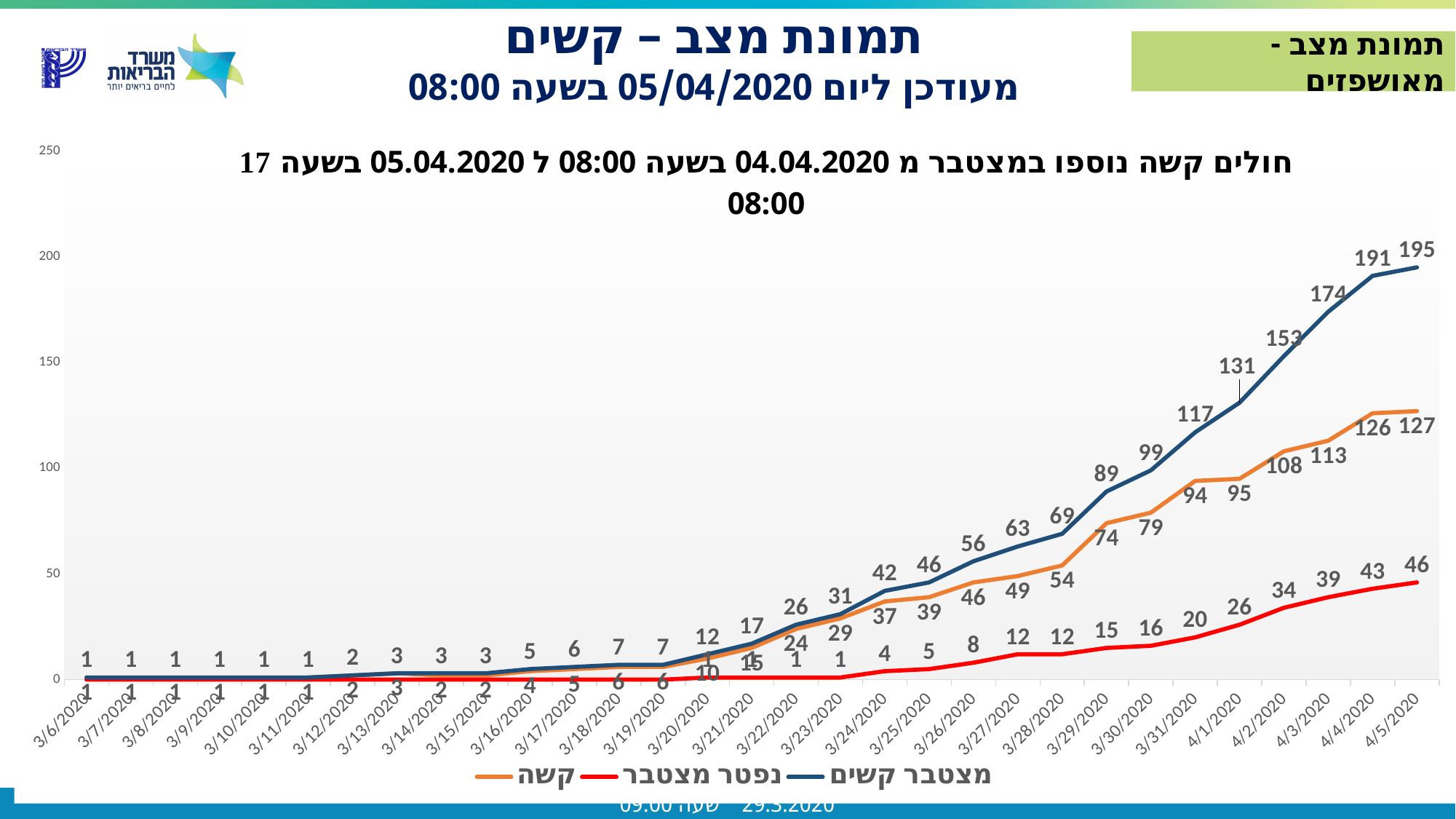
What is the value of קשה on 4/5/2020? 127 How many dates are shown on the x axis? 31 What is the value of נפטר מצטבר on 4/2/2020? 34 What is the value of נפטר מצטבר on 4/5/2020? 46 By how much did מצטבר קשים increase from 4/4/2020 to 4/5/2020? 4 What is the value of מצטבר קשים on 4/1/2020? 131 On 4/3/2020, which is larger: מצטבר קשים or קשה? מצטבר קשים Which series has the highest value on 4/5/2020? מצטבר קשים What kind of chart is shown on the slide? line chart Does the מצטבר קשים line rise or fall over the dates shown? rises What is the value of מצטבר קשים on 4/5/2020? 195 How many series does the legend list? 3